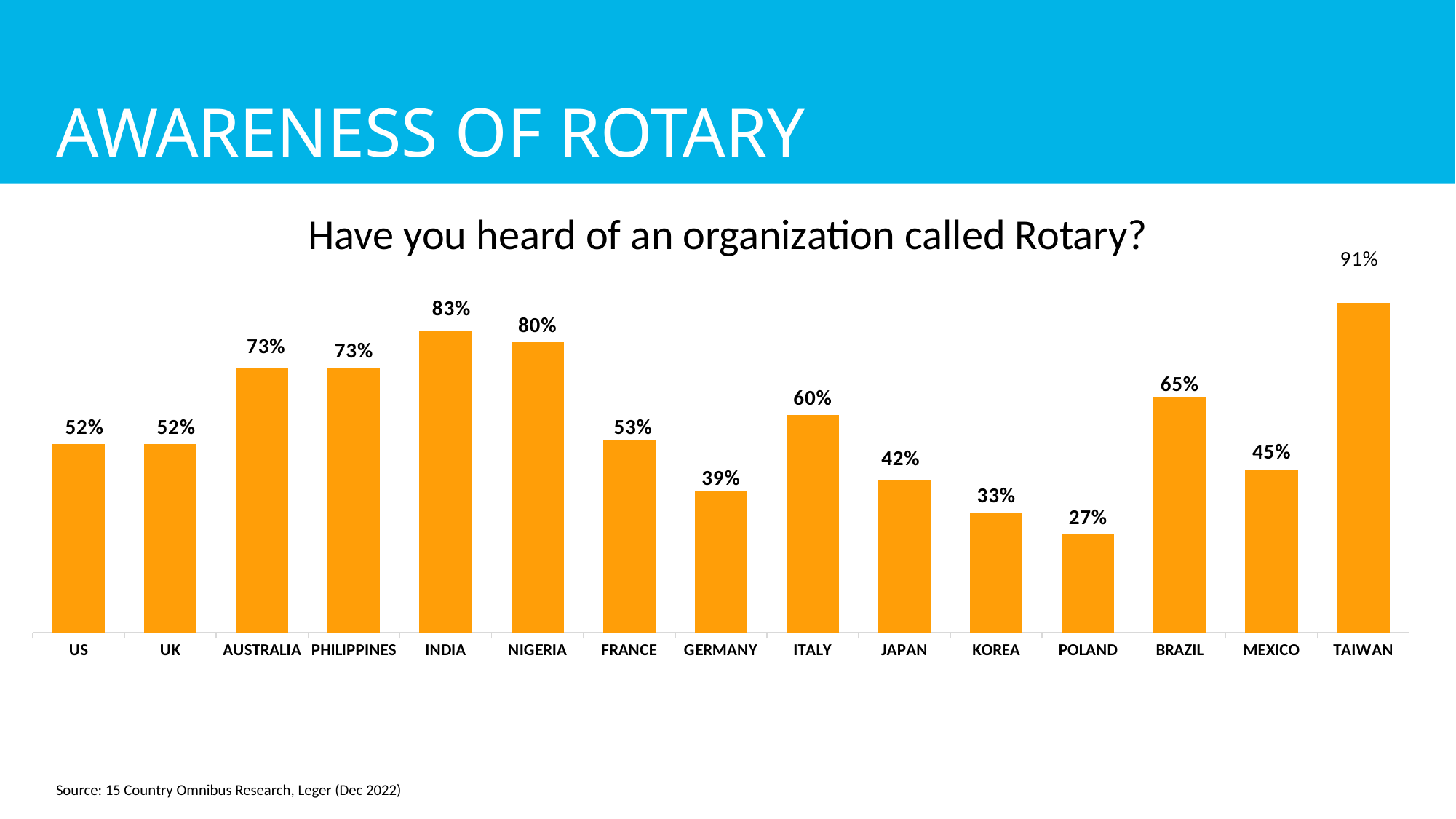
Which has a higher value, Italy or Japan? Italy What question is shown as the chart title? Have you heard of an organization called Rotary? What is the value shown for Brazil? 65% Which has a higher value, France or Korea? France What is the difference between the values for Taiwan and Mexico? 46% How many countries are shown in the chart? 15 What is the difference between the values for Nigeria and Germany? 41% Which country has the highest awareness of Rotary? Taiwan Which country has the lowest awareness of Rotary? Poland What is the value shown for Poland? 27% What percentage of respondents in India have heard of Rotary? 83% What type of chart is shown on the slide? Bar chart